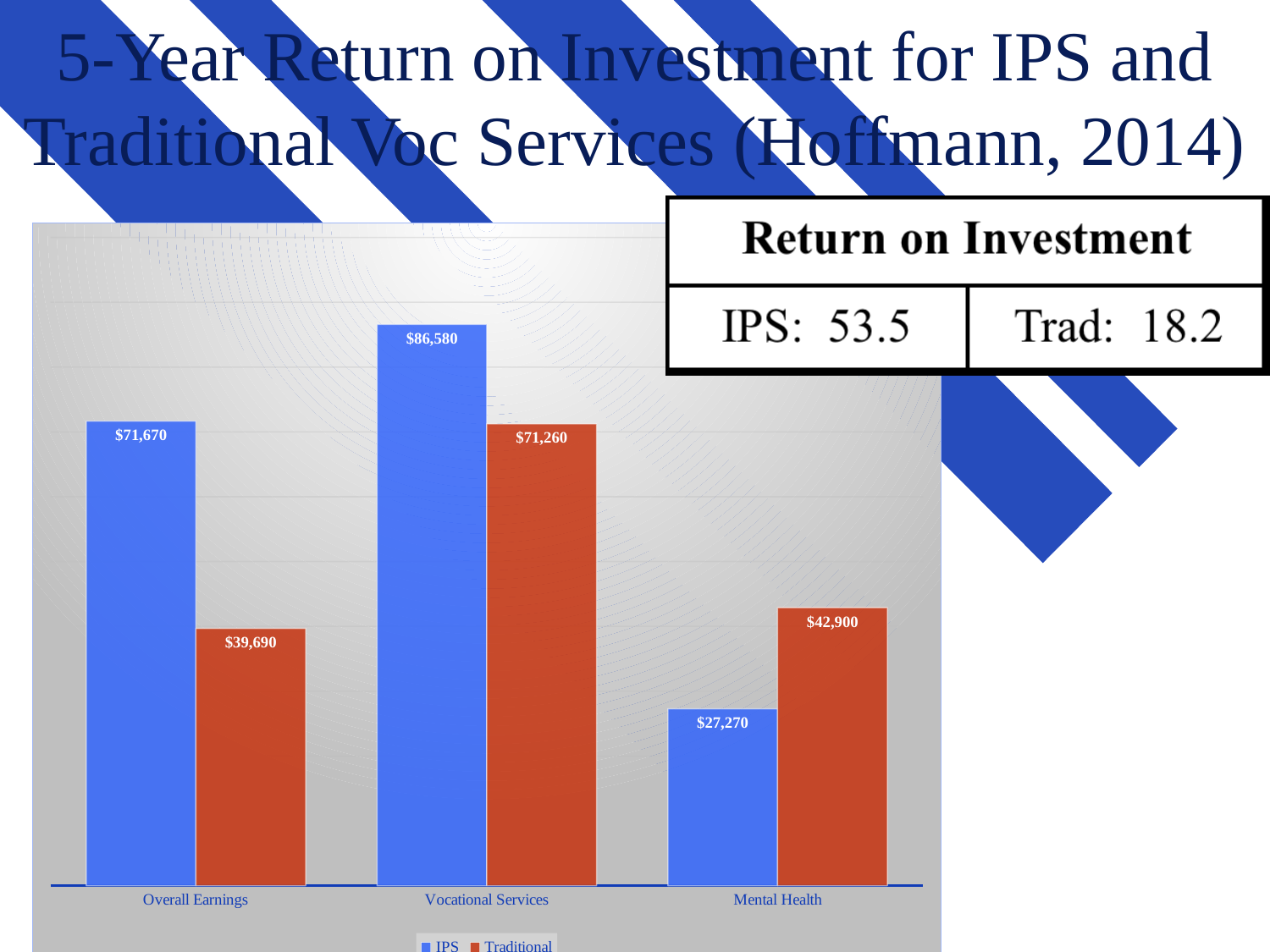
For Mental Health, which series has the larger value, IPS or Traditional? Traditional Which category has the lowest Traditional value? Overall Earnings What is the Traditional value for Overall Earnings? $39,690 Which colour represents the Traditional series in the chart? Red What is the Traditional value for Vocational Services? $71,260 What is the IPS value for Overall Earnings? $71,670 What is the IPS value for Mental Health? $27,270 How many series does the chart legend list? 2 What kind of chart is shown on the slide? Bar chart What is the difference between the IPS and Traditional values for Overall Earnings? $31,980 Which category has the highest IPS value? Vocational Services How many categories are shown on the x axis of the chart? 3